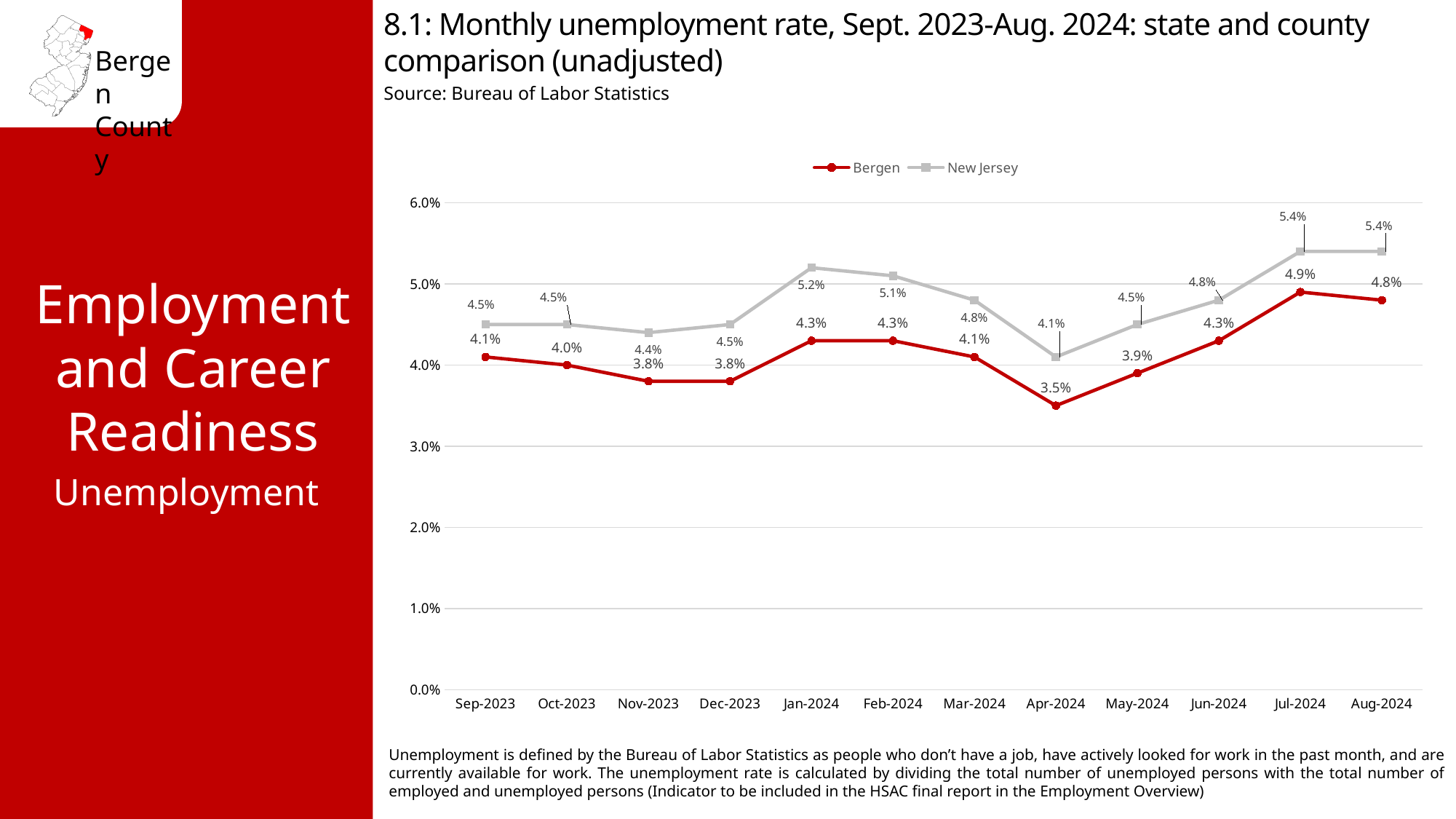
Which series has the higher value in Feb-2024, Bergen or New Jersey? New Jersey What is the difference between the New Jersey and Bergen unemployment rates in Jul-2024? 0.5% What is the Bergen unemployment rate for Nov-2023? 3.8% What is the Bergen unemployment rate for Apr-2024? 3.5% How many series does the legend list? 2 Is the Bergen value for Apr-2024 greater or less than 4.0%? less Does the Bergen unemployment rate rise or fall from Apr-2024 to Jul-2024? Rise What is the New Jersey unemployment rate for Jan-2024? 5.2% What kind of chart is shown on the slide? Line chart In which month is the New Jersey unemployment rate lowest? Apr-2024 How many months are shown on the x axis? 12 In which month does the Bergen series reach its highest value? Jul-2024